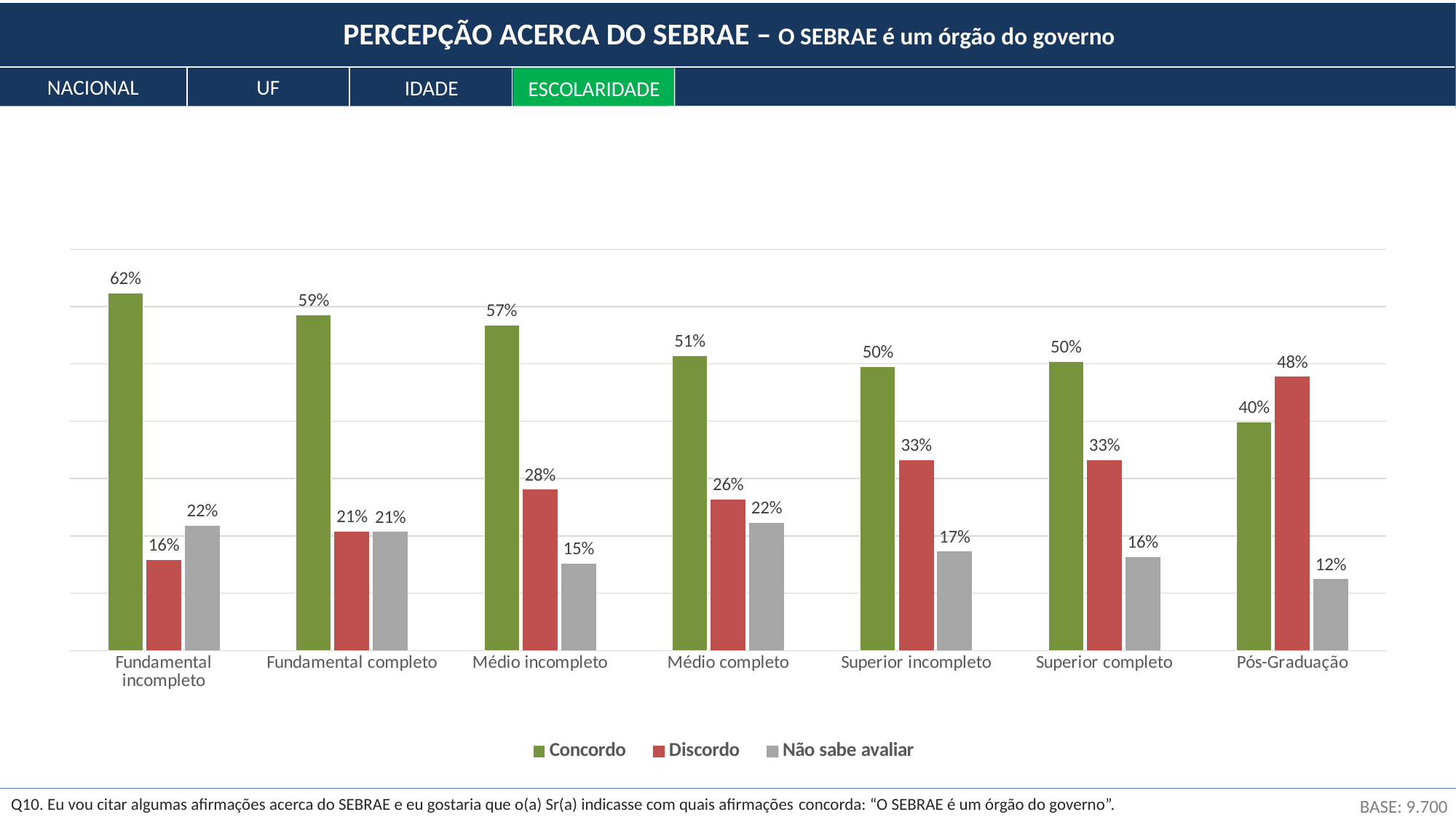
Which tab is highlighted in green below the title? ESCOLARIDADE Do the Concordo values rise or fall from Fundamental incompleto to Pós-Graduação? Fall What is the Não sabe avaliar value for Médio completo? 22% Which category has the highest Concordo value? Fundamental incompleto How many education categories are shown on the x axis? 7 Which category has the lowest Não sabe avaliar value? Pós-Graduação Which is larger for Superior completo: Discordo or Não sabe avaliar? Discordo How many series does the legend list? 3 What is the difference between the Concordo and Discordo values for Médio incompleto? 29% What is the Concordo value for Fundamental incompleto? 62% What kind of chart is shown on the slide? Bar chart What is the Discordo value for Pós-Graduação? 48%